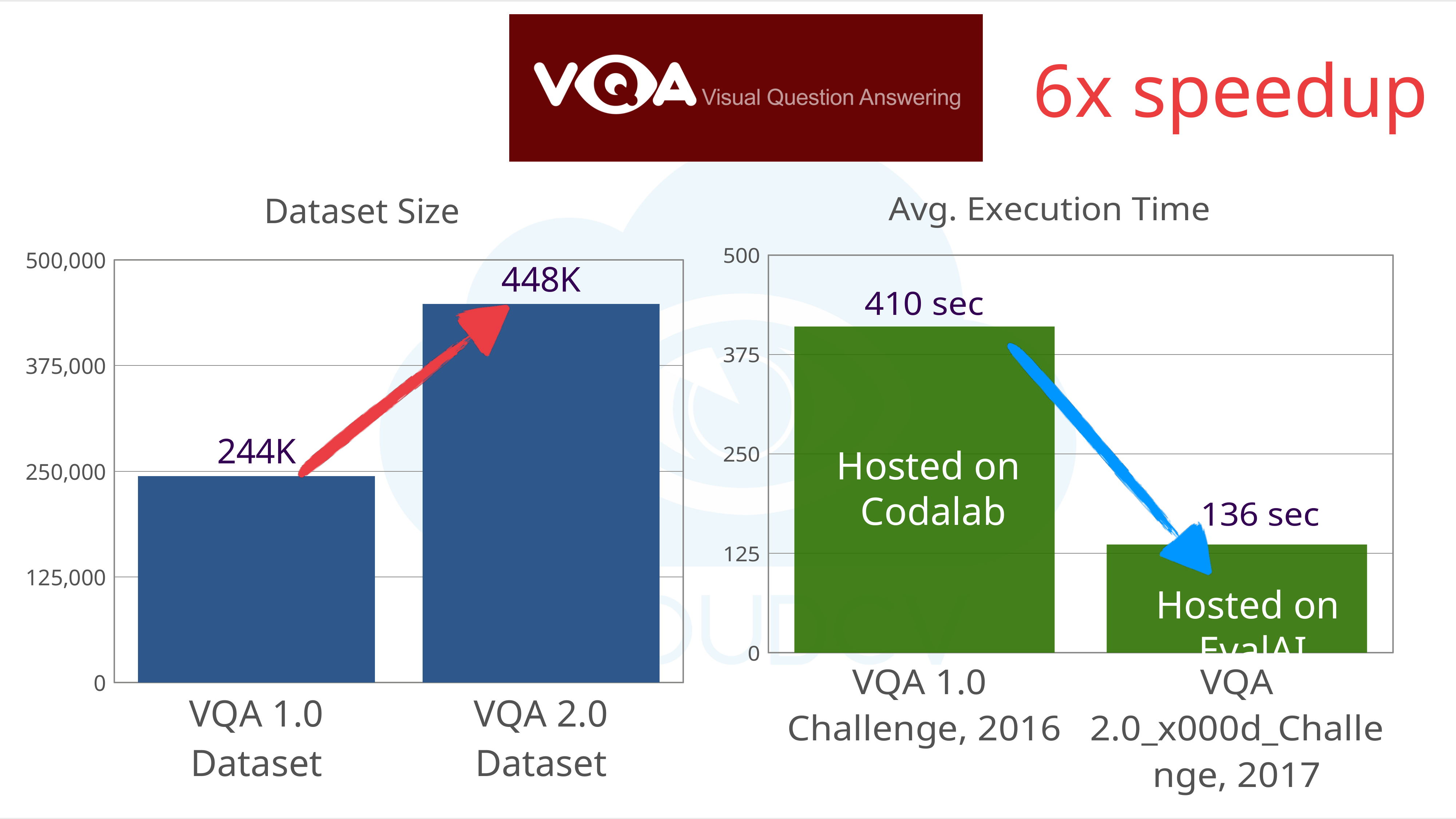
In the Avg. Execution Time chart, where was the VQA 1.0 Challenge, 2016 hosted according to the bar label? Codalab In the Dataset Size chart, what is the difference between the VQA 2.0 Dataset and the VQA 1.0 Dataset? 204K In the Avg. Execution Time chart, what is the value for the VQA 2.0 Challenge, 2017? 136 sec In the Avg. Execution Time chart, is the value for the VQA 1.0 Challenge, 2016 greater or less than 375? greater In the Avg. Execution Time chart, what is the difference between the VQA 1.0 Challenge, 2016 and the VQA 2.0 Challenge, 2017? 274 sec How many bars are in the Dataset Size chart? 2 In the Avg. Execution Time chart, which challenge has the lowest average execution time? VQA 2.0 Challenge, 2017 In the Dataset Size chart, what is the value for the VQA 2.0 Dataset? 448K What kind of chart is the Avg. Execution Time chart? bar chart In the Dataset Size chart, which dataset has the larger size? VQA 2.0 Dataset In the Avg. Execution Time chart, what is the value for the VQA 1.0 Challenge, 2016? 410 sec In the Dataset Size chart, what is the value for the VQA 1.0 Dataset? 244K